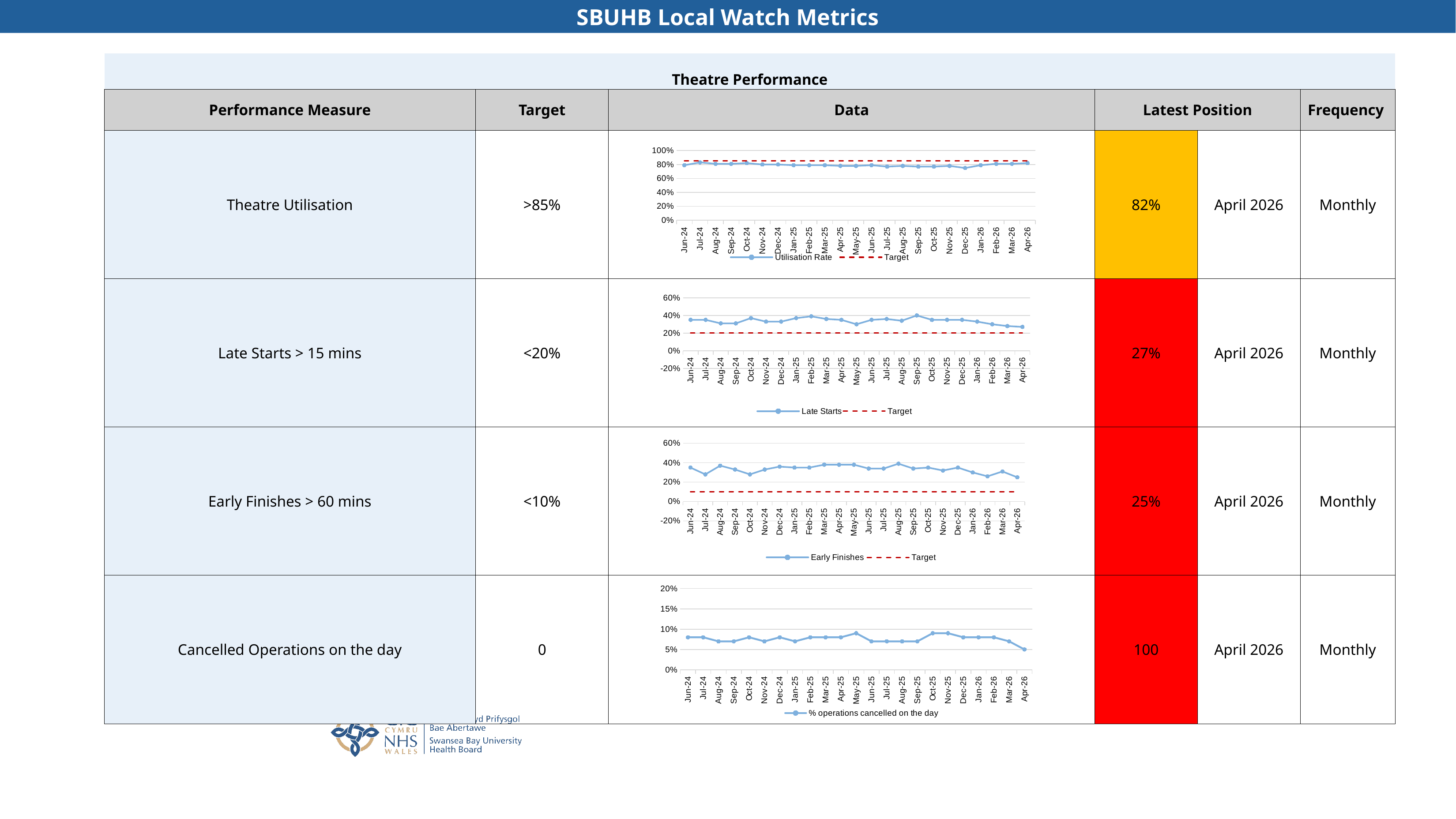
In the Cancelled Operations on the day chart, which month has the lowest value? Apr-26 In the Late Starts > 15 mins chart, is the Late Starts value for Sep-25 greater or less than 20%? greater How many series does the legend of the Theatre Utilisation chart list? 2 How many monthly points are plotted on the x axis of the Late Starts > 15 mins chart? 23 In the Theatre Utilisation chart, is the Utilisation Rate for Jun-24 greater or less than 60%? greater What is the legend entry for the series plotted in the Cancelled Operations on the day chart? % operations cancelled on the day In the Cancelled Operations on the day chart, is the value for May-25 greater or less than 5%? greater In the Late Starts > 15 mins chart, which month has the highest Late Starts value? Sep-25 In the Late Starts > 15 mins chart, which is larger: the value for Sep-25 or the value for Apr-26? Sep-25 In the Late Starts > 15 mins chart, do the Late Starts values rise or fall from Sep-25 to Apr-26? fall What kind of chart is used in the Theatre Utilisation row? Line chart How many series does the legend of the Cancelled Operations on the day chart list? 1